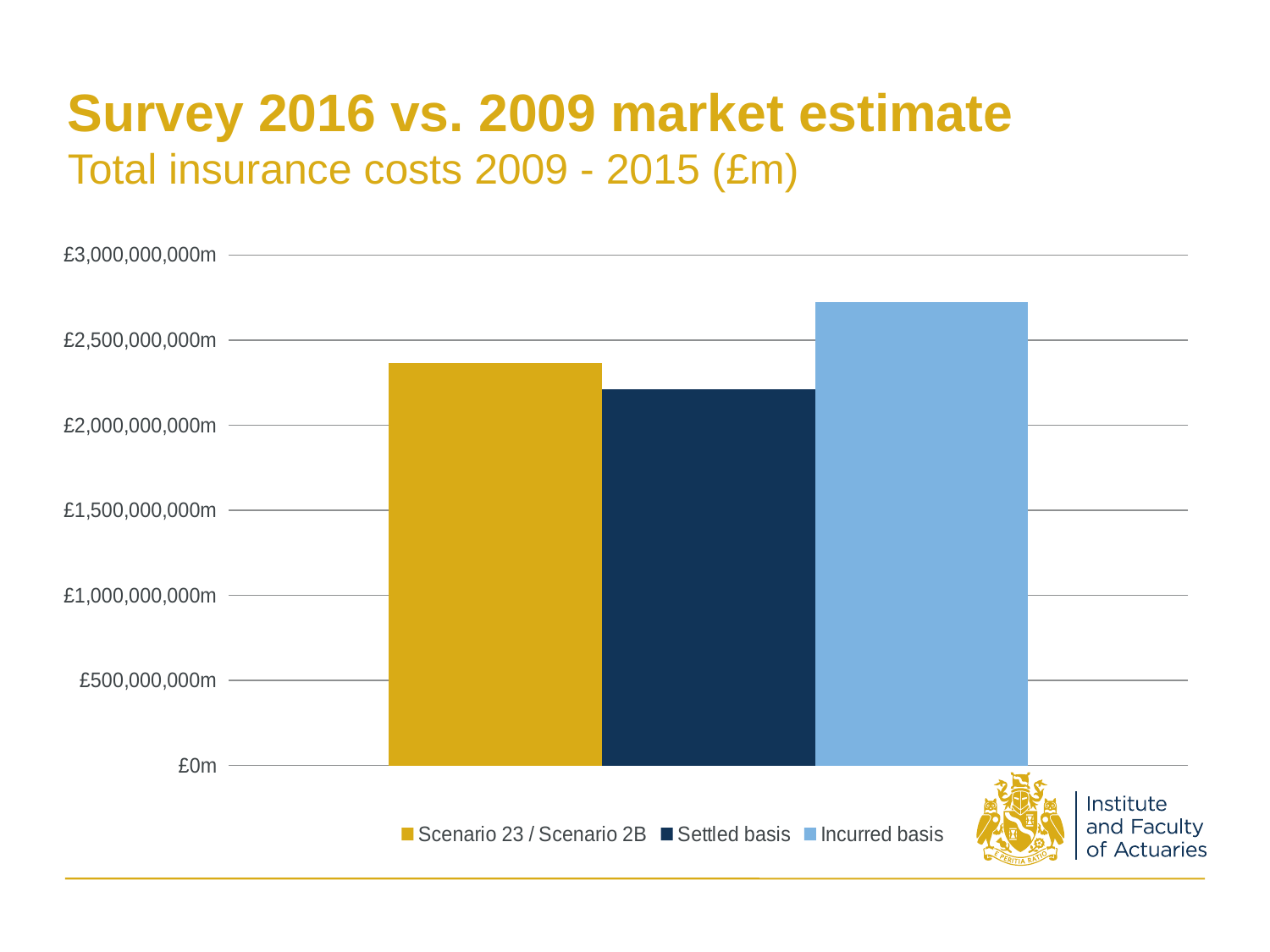
Is the value for Incurred basis greater or less than £2,500,000,000m? greater How many bars are plotted in the chart? 3 Is the value for Scenario 23 / Scenario 2B greater or less than £2,500,000,000m? less Which series is shown in the gold/yellow colour in the legend? Scenario 23 / Scenario 2B Is the value for Settled basis greater or less than £2,000,000,000m? greater Which is larger, the value for Scenario 23 / Scenario 2B or the value for Settled basis? Scenario 23 / Scenario 2B What is the subtitle of the chart shown on the slide? Total insurance costs 2009 - 2015 (£m) Which series has the highest value? Incurred basis What kind of chart is shown on the slide? bar chart Which is larger, the value for Incurred basis or the value for Settled basis? Incurred basis Which series has the lowest value? Settled basis How many series does the legend list? 3